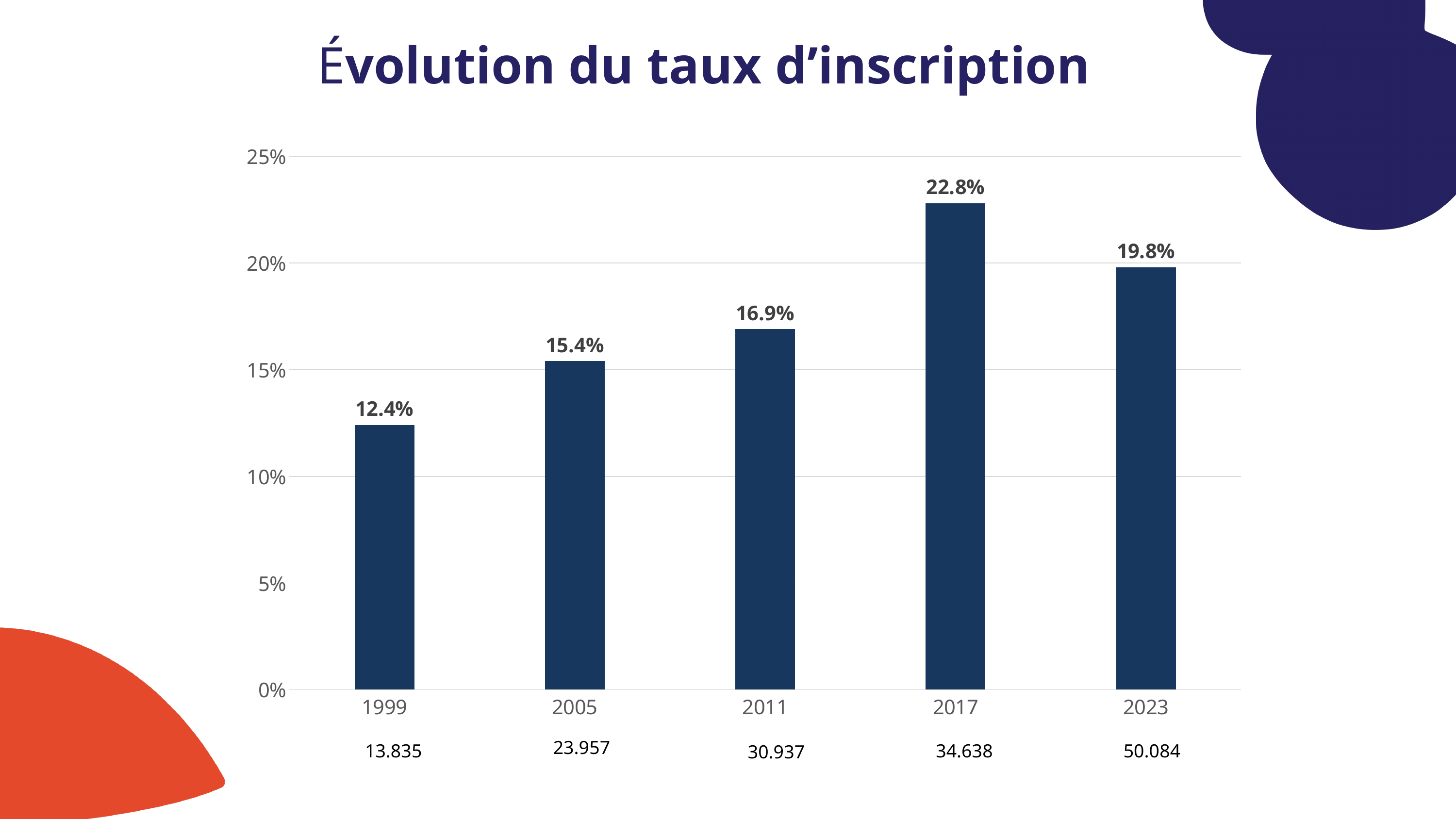
What is the value for 1999? 12.4% Which year has the lowest value? 1999 What is the difference between the values for 2017 and 2023? 3.0% Is the value for 2023 greater or less than 20%? less What kind of chart is shown on the slide? bar chart What is the value for 2017? 22.8% Which is larger, the value for 2005 or the value for 2011? 2011 How many years are shown on the chart? 5 What is the difference between the values for 2011 and 2005? 1.5% What is the value for 2023? 19.8% What is the title of the chart? Évolution du taux d’inscription Which year has the highest value? 2017